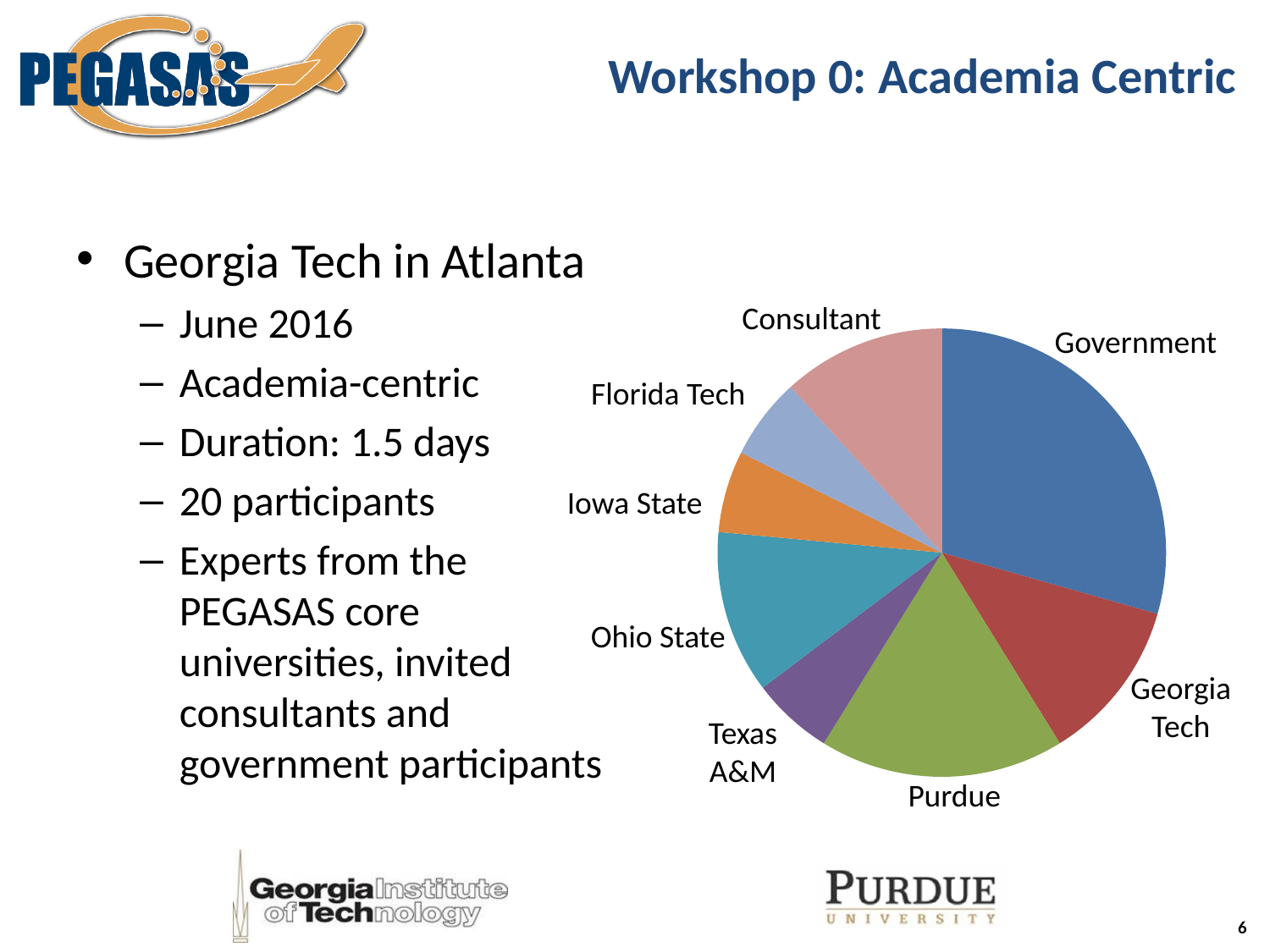
Which slice is larger, Purdue or Texas A&M? Purdue What colour is the Government slice of the pie chart? blue Which slice is larger, Government or Ohio State? Government Which category is represented by the green slice of the pie chart? Purdue Which slice is larger, Government or Consultant? Government What kind of chart is shown on the slide? pie chart How many slices does the pie chart have? 8 Which category has the largest slice of the pie chart? Government